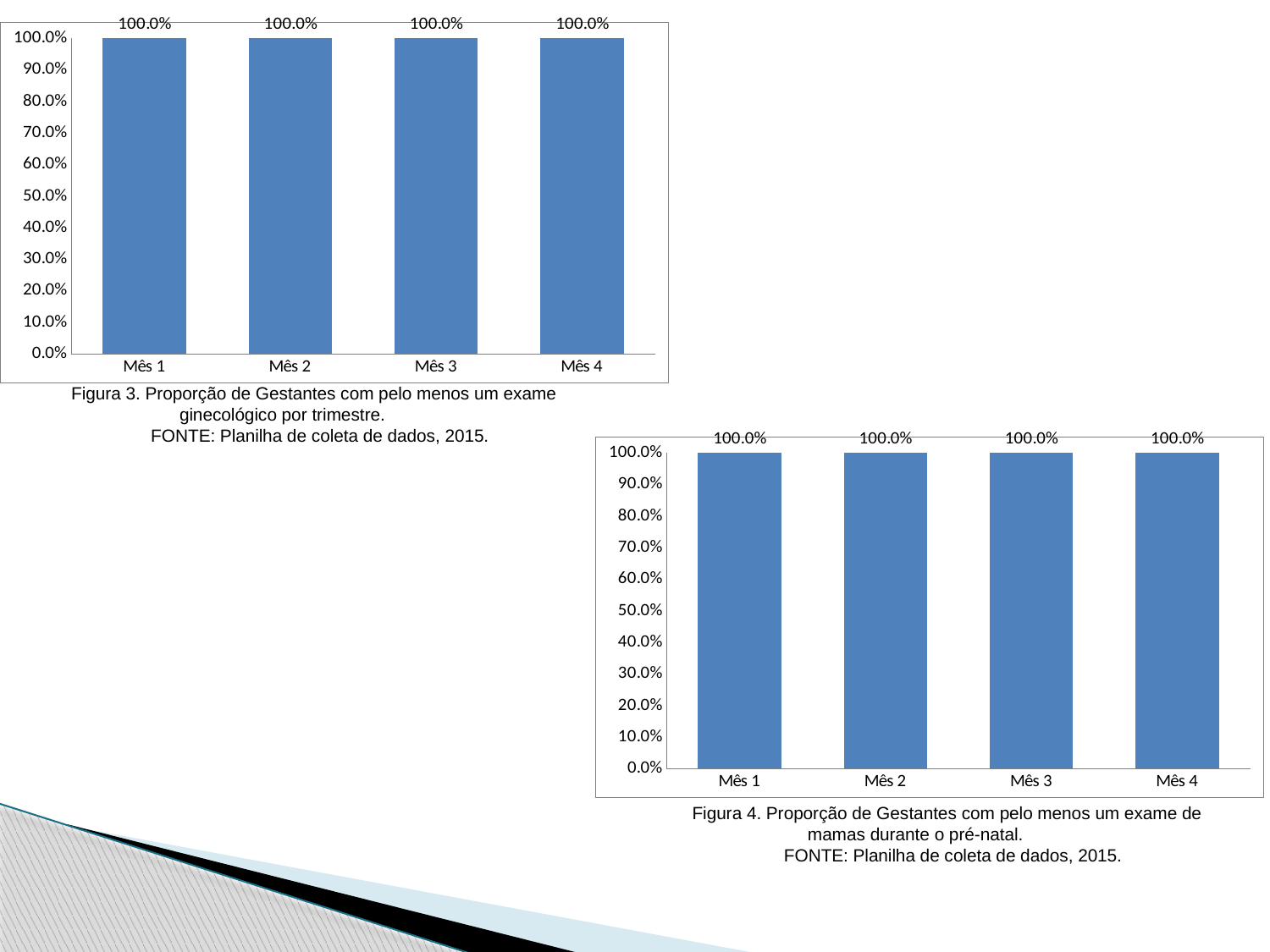
What source is cited below the Figura 4 chart (bottom right)? FONTE: Planilha de coleta de dados, 2015. In the Figura 4 chart (bottom right), do the values rise, fall, or stay the same from Mês 1 to Mês 4? Stay the same In the Figura 4 chart (bottom right), what is the value for Mês 2? 100.0% In the Figura 4 chart (bottom right), what is the value for Mês 4? 100.0% In the Figura 4 chart (bottom right), how many bars are plotted? 4 In the Figura 3 chart (top left), how many categories are shown on the x axis? 4 What is the caption of the chart at the top left of the slide? Figura 3. Proporção de Gestantes com pelo menos um exame ginecológico por trimestre. In the Figura 3 chart (top left), what is the value for Mês 1? 100.0% What kind of chart is the Figura 4 chart (bottom right)? Bar chart In the Figura 3 chart (top left), is the value for Mês 4 greater or less than 50.0%? greater In the Figura 3 chart (top left), what is the difference between the values for Mês 2 and Mês 3? 0.0% What kind of chart is the Figura 3 chart (top left)? Bar chart